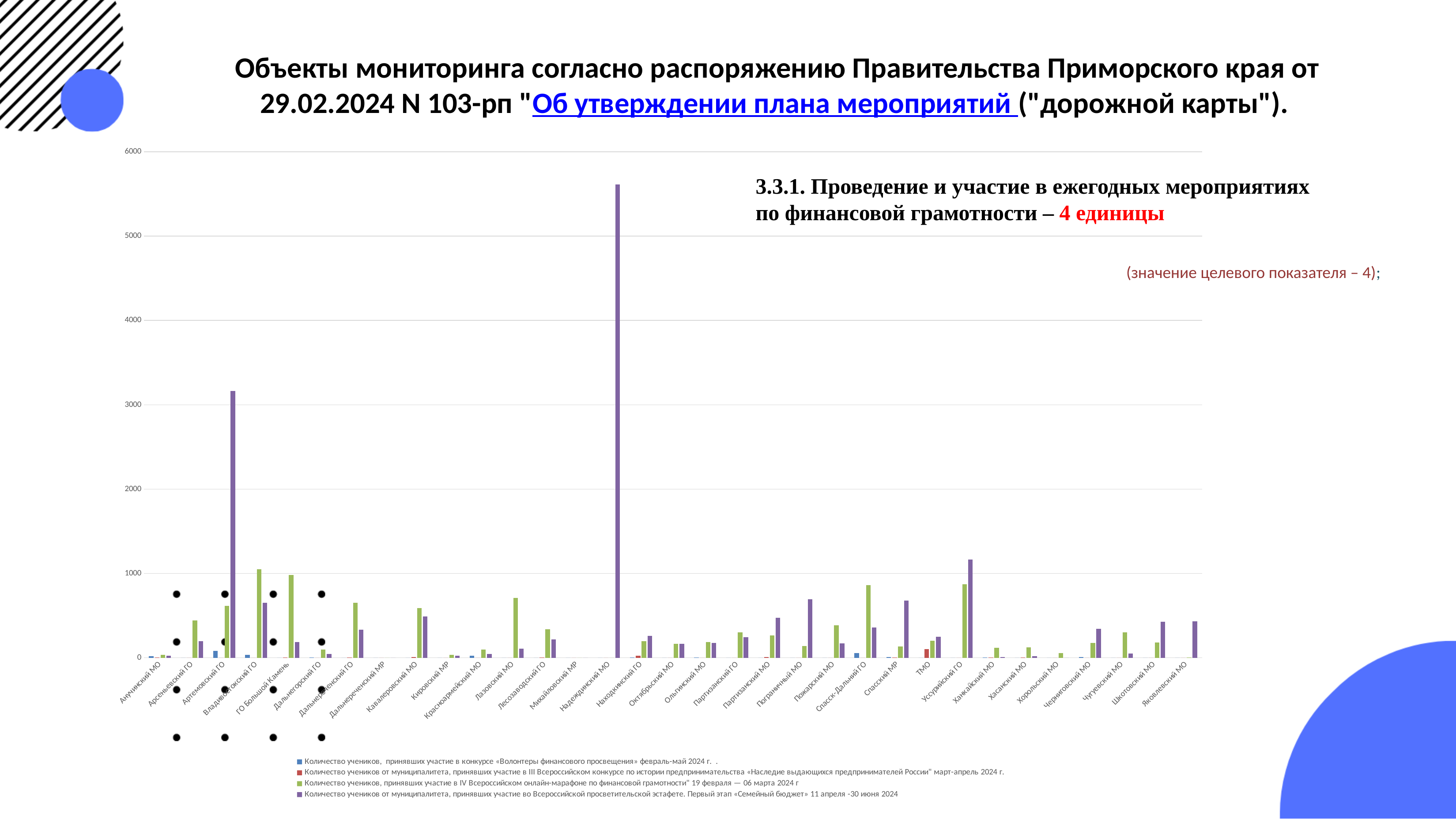
Is the green bar (IV Всероссийский онлайн-марафон по финансовой грамотности) for Спасск-Дальний ГО greater or less than 1000? less Is the purple bar (Всероссийская просветительская эстафета «Семейный бюджет») for Артемовский ГО greater or less than 2000? greater Is the green bar (IV Всероссийский онлайн-марафон по финансовой грамотности) for Владивостокский ГО greater or less than 500? greater Which has the taller green bar: Владивостокский ГО or Анучинский МО? Владивостокский ГО How many municipalities (categories) are shown along the x axis of the chart? 33 What kind of chart is shown on the slide? bar chart Which series in the legend is shown in purple? Количество учеников от муниципалитета, принявших участие во Всероссийской просветительской эстафете. Первый этап «Семейный бюджет» 11 апреля -30 июня 2024 How many series does the chart legend list? 4 Which has the taller purple bar: Надеждинский МО or Артемовский ГО? Надеждинский МО Which municipality has the highest bar in the chart? Надеждинский МО